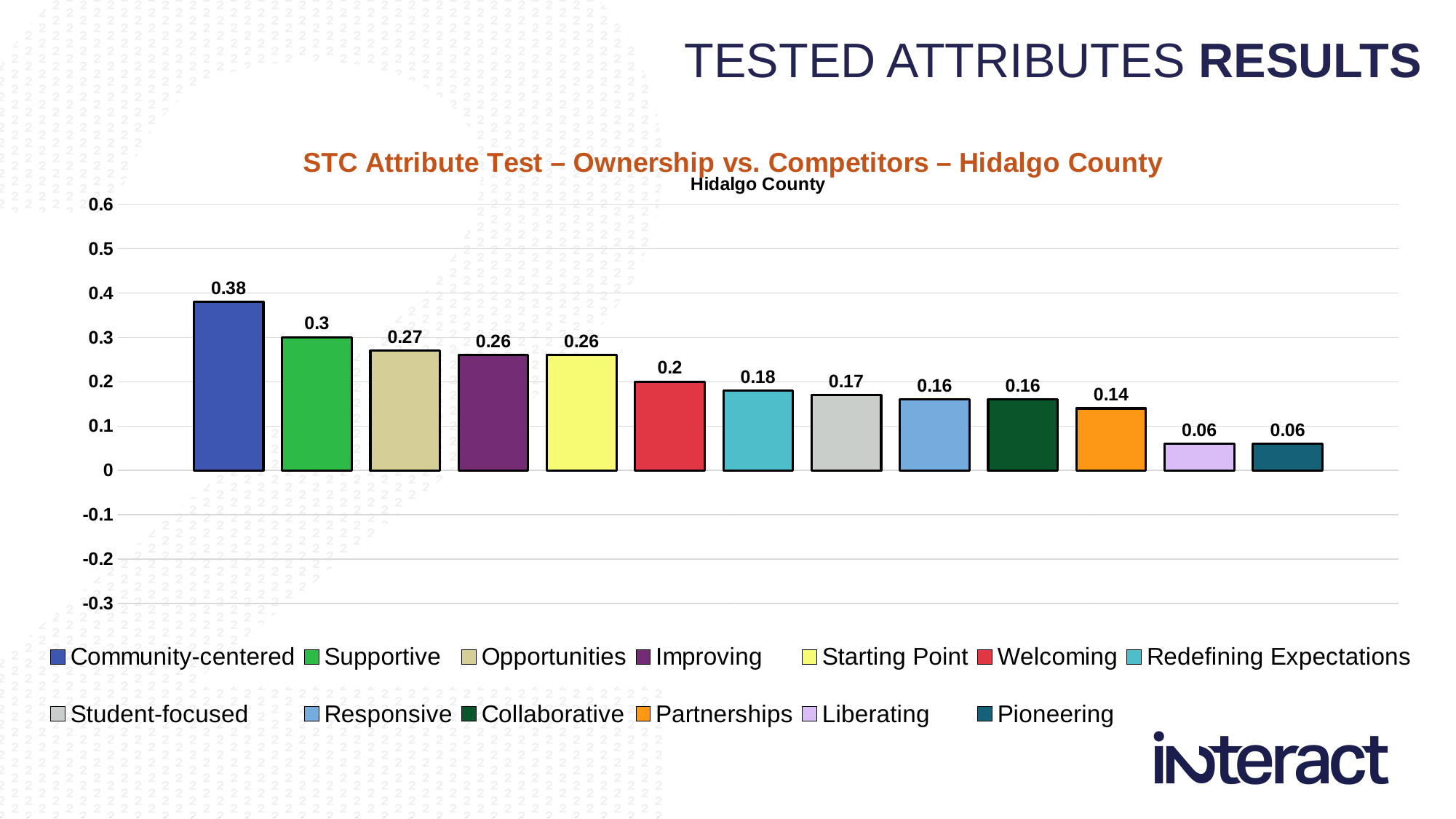
How many entries does the legend list? 13 What is the value for Welcoming? 0.2 Which two attributes share the lowest value? Liberating and Pioneering What is the difference between the values for Opportunities and Student-focused? 0.1 Which attribute has the highest value? Community-centered What kind of chart is shown on the slide? Bar chart What is the difference between the values for Community-centered and Supportive? 0.08 How many bars are plotted in the chart? 13 What is the value for Redefining Expectations? 0.18 What is the value for Community-centered? 0.38 Which is larger, the value for Supportive or the value for Welcoming? Supportive What is the value for Partnerships? 0.14